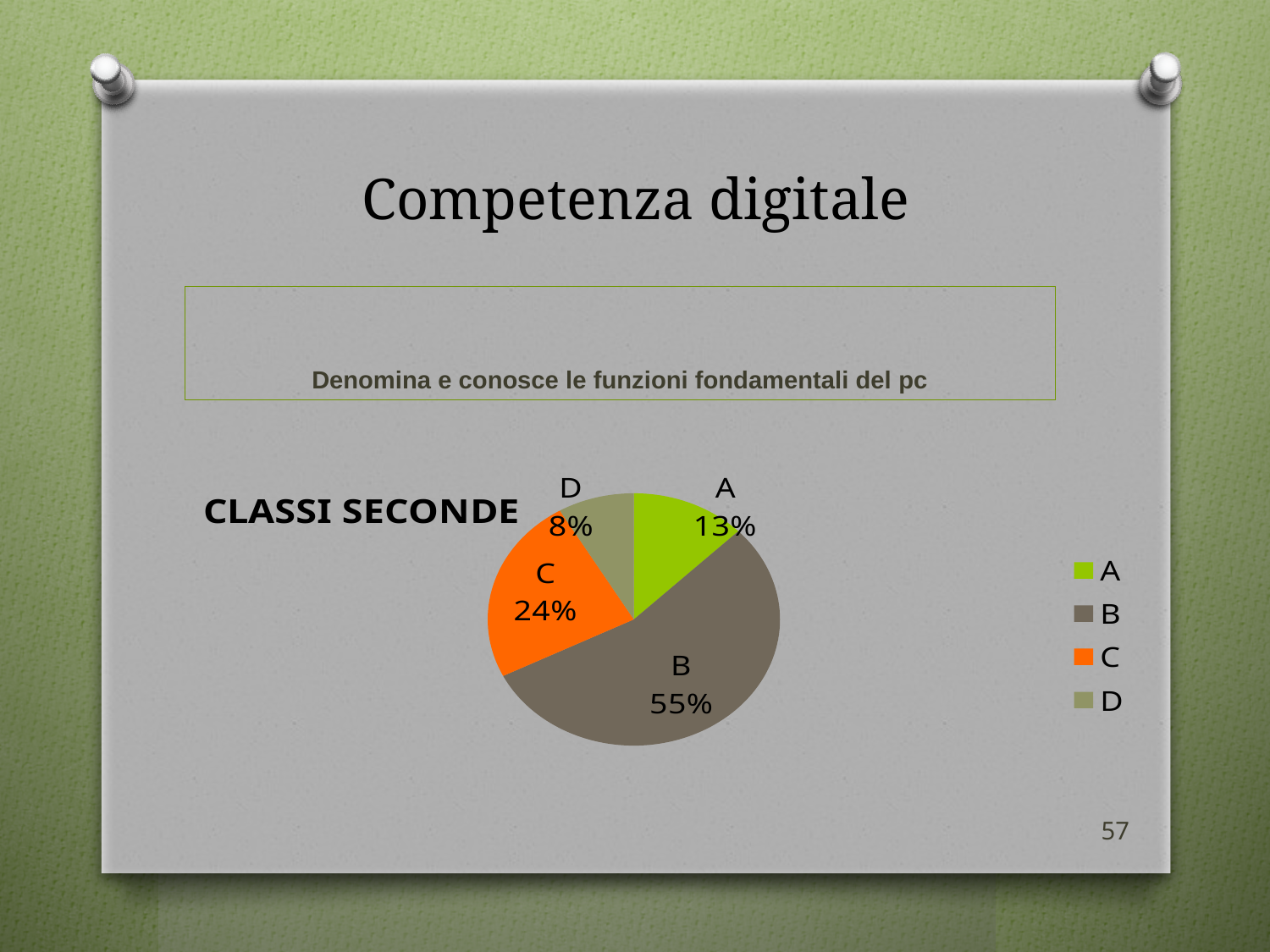
What percentage does slice D represent? 8% What percentage does slice C represent? 24% What percentage does slice B represent? 55% How many entries does the legend list? 4 Which slice is the smallest? D What colour is slice C in the pie chart? orange How many slices does the pie chart have? 4 What is the difference in percentage points between slice B and slice C? 31 Which is larger, slice A or slice C? C Which slice is the largest? B What kind of chart is shown on the slide? pie chart What percentage does slice A represent? 13%